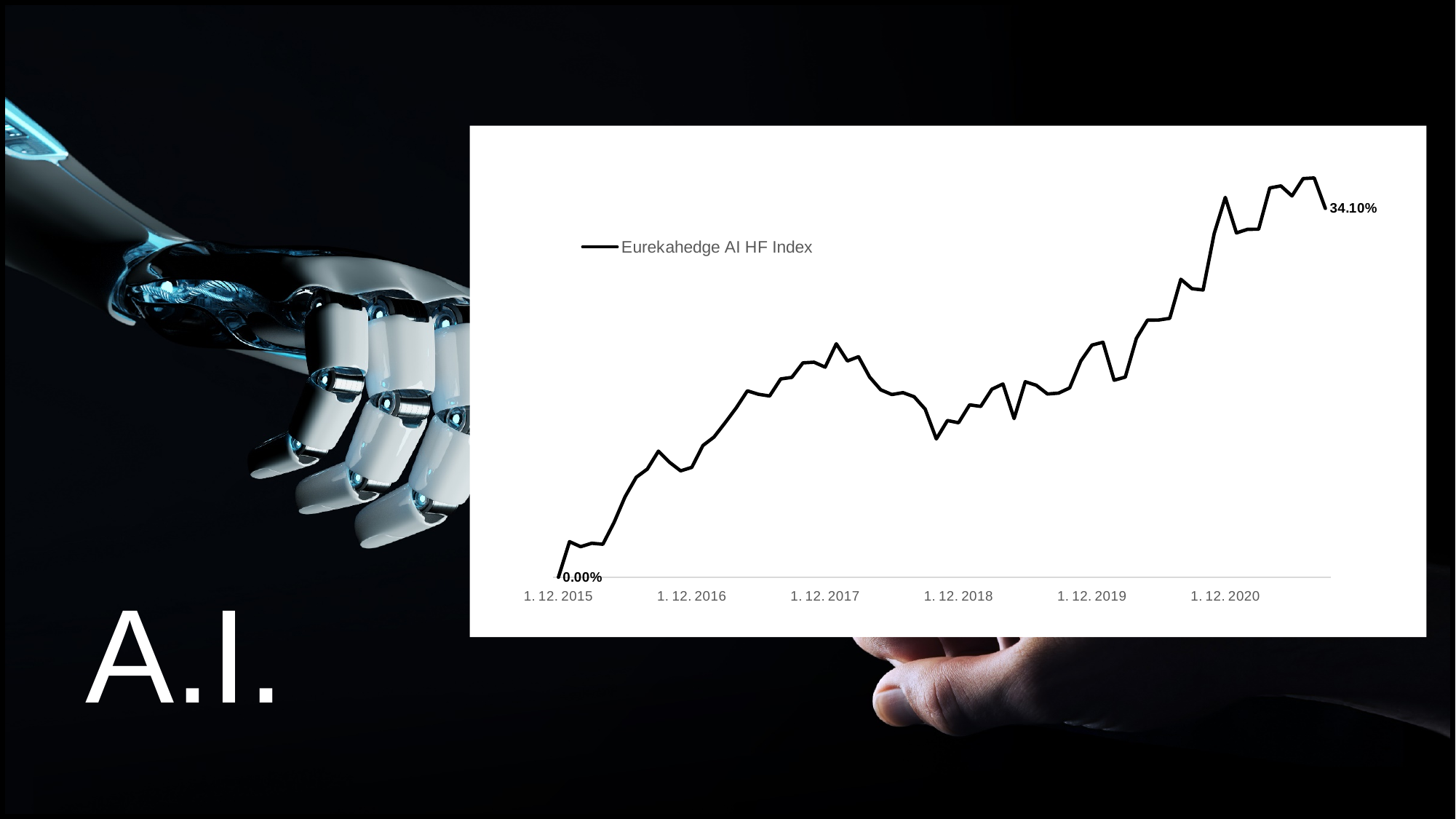
What kind of chart is shown on the slide? line chart How many date labels are shown on the x axis? 6 What is the difference between the last labelled value (34.10%) and the first labelled value (0.00%) on the line? 34.10% What value is labelled at the end of the Eurekahedge AI HF Index line? 34.10% What is the last date label on the x axis? 1. 12. 2020 What colour is the Eurekahedge AI HF Index line? black Overall, does the Eurekahedge AI HF Index line rise or fall from left to right along the x axis? rise How many series does the chart's legend list? 1 What value is labelled at the start of the Eurekahedge AI HF Index line? 0.00% Which labelled value is larger: the one at the start of the line or the one at the end of the line? the end of the line (34.10%) What is the name of the series shown in the chart's legend? Eurekahedge AI HF Index What is the first date label on the x axis? 1. 12. 2015